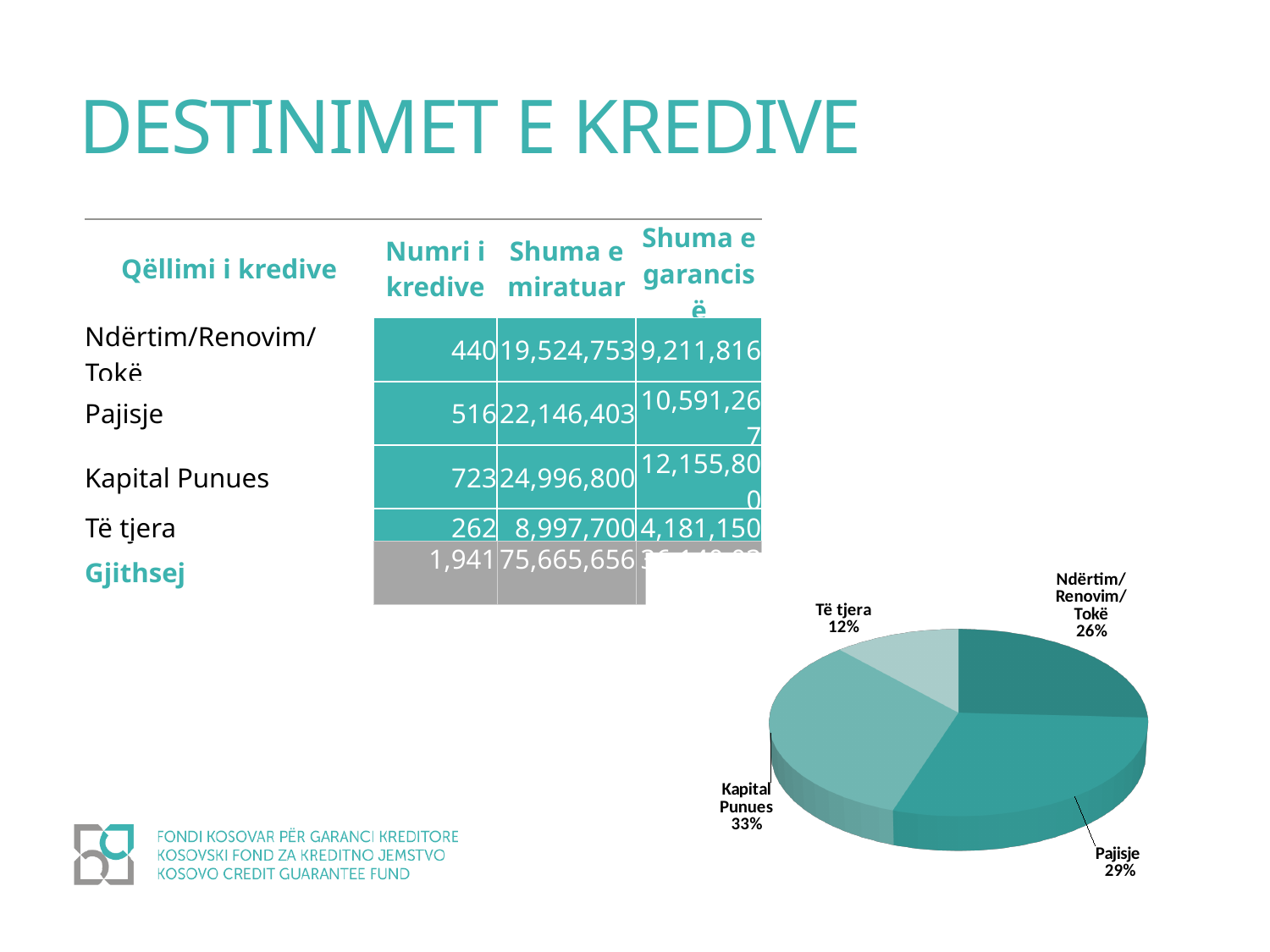
Which slice of the pie chart is the largest? Kapital Punues What share of the pie chart does Të tjera have? 12% In the pie chart, which is larger: Pajisje or Ndërtim/Renovim/Tokë? Pajisje What kind of chart is shown on the slide? pie chart In the pie chart, what is the difference in percentage points between Pajisje and Ndërtim/Renovim/Tokë? 3 In the pie chart, what is the difference in percentage points between Kapital Punues and Të tjera? 21 How many slices does the pie chart have? 4 Is the pie chart drawn in 3D or flat 2D? 3D Which slice of the pie chart is the smallest? Të tjera What share of the pie chart does Kapital Punues have? 33% What share of the pie chart does Ndërtim/Renovim/Tokë have? 26%